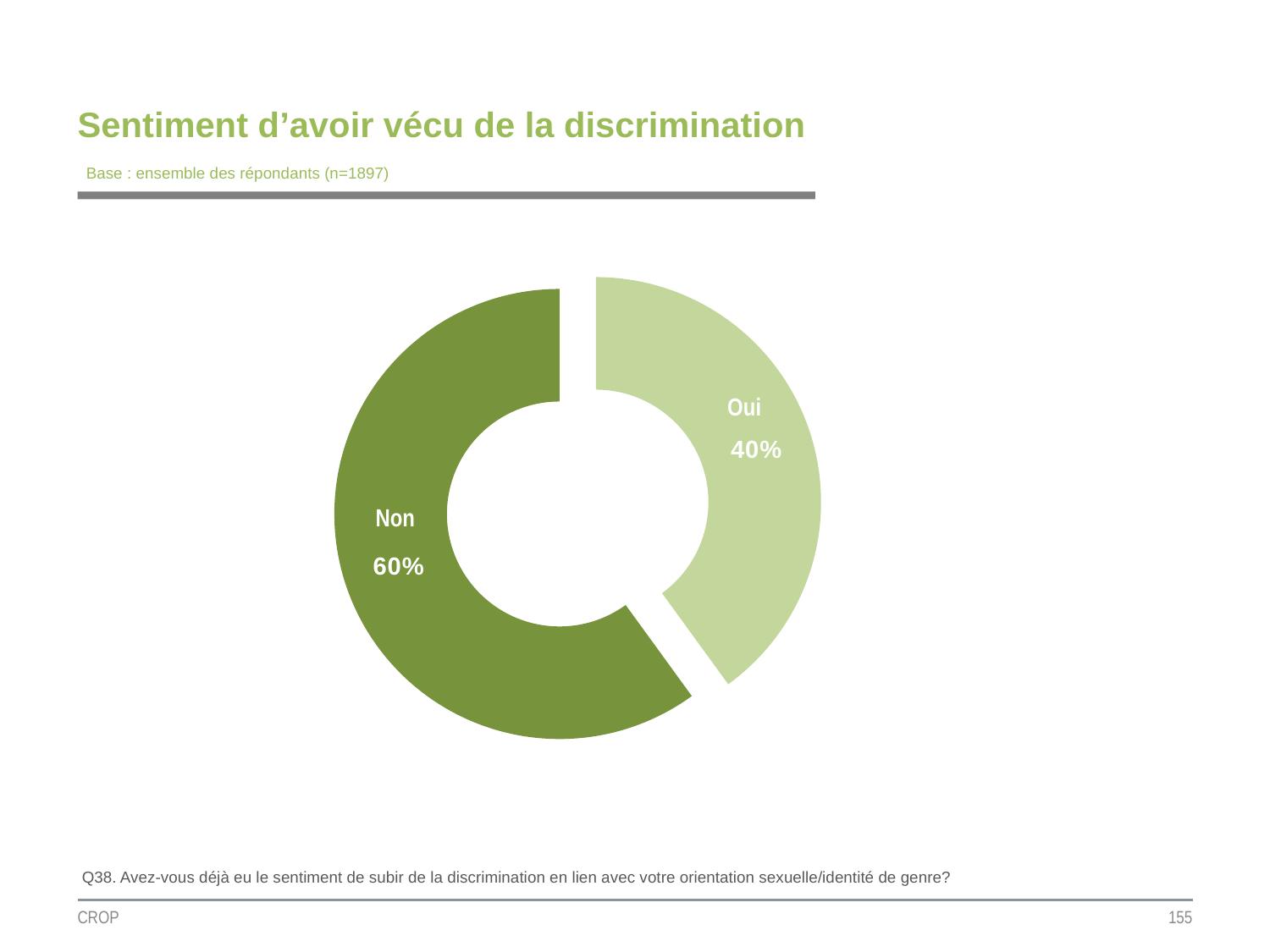
What percentage of respondents answered "Oui"? 40% Which category has the smallest share of the chart? Oui What kind of chart is shown on the slide? Doughnut chart What is the difference in percentage points between "Non" and "Oui"? 20 Which category has the largest share of the chart? Non How many categories are shown in the chart? 2 Which response has the larger share, "Oui" or "Non"? Non What percentage of respondents answered "Non"? 60% What is the combined total of the "Oui" and "Non" shares? 100% What is the title of the slide containing the chart? Sentiment d’avoir vécu de la discrimination What is the base (number of respondents) stated for the chart? n=1897